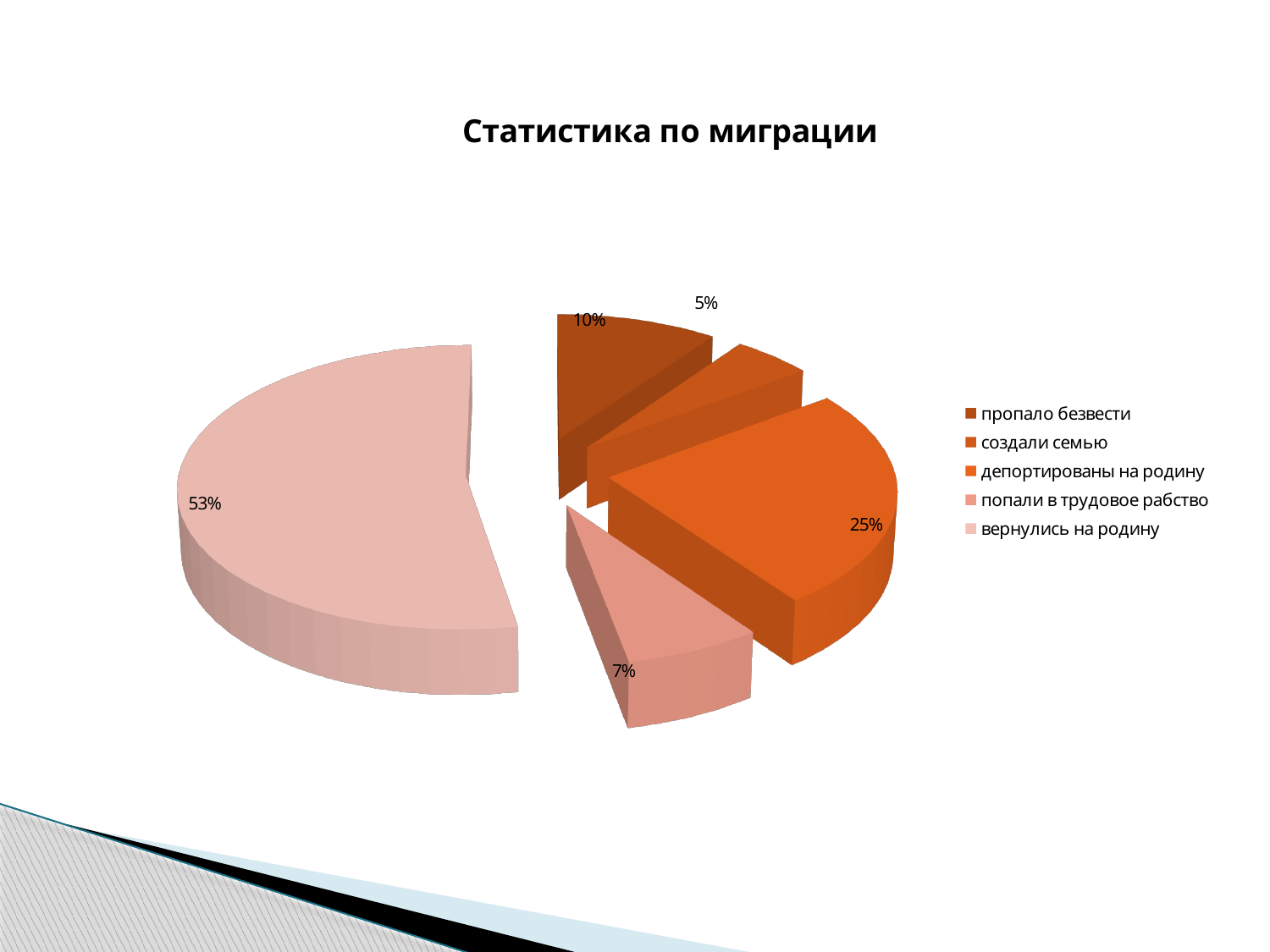
Which is larger, the share for "пропало безвести" or the share for "попали в трудовое рабство"? пропало безвести How many categories does the legend list? 5 What share of the pie is labelled "вернулись на родину"? 53% What is the value for "пропало безвести"? 10% Which category has the smallest slice? создали семью What share of the pie is labelled "депортированы на родину"? 25% What is the title of the chart? Статистика по миграции What is the value for "создали семью"? 5% What is the difference between the shares for "вернулись на родину" and "депортированы на родину"? 28% Which category has the largest slice? вернулись на родину What kind of chart is shown on the slide? pie chart What is the value for "попали в трудовое рабство"? 7%